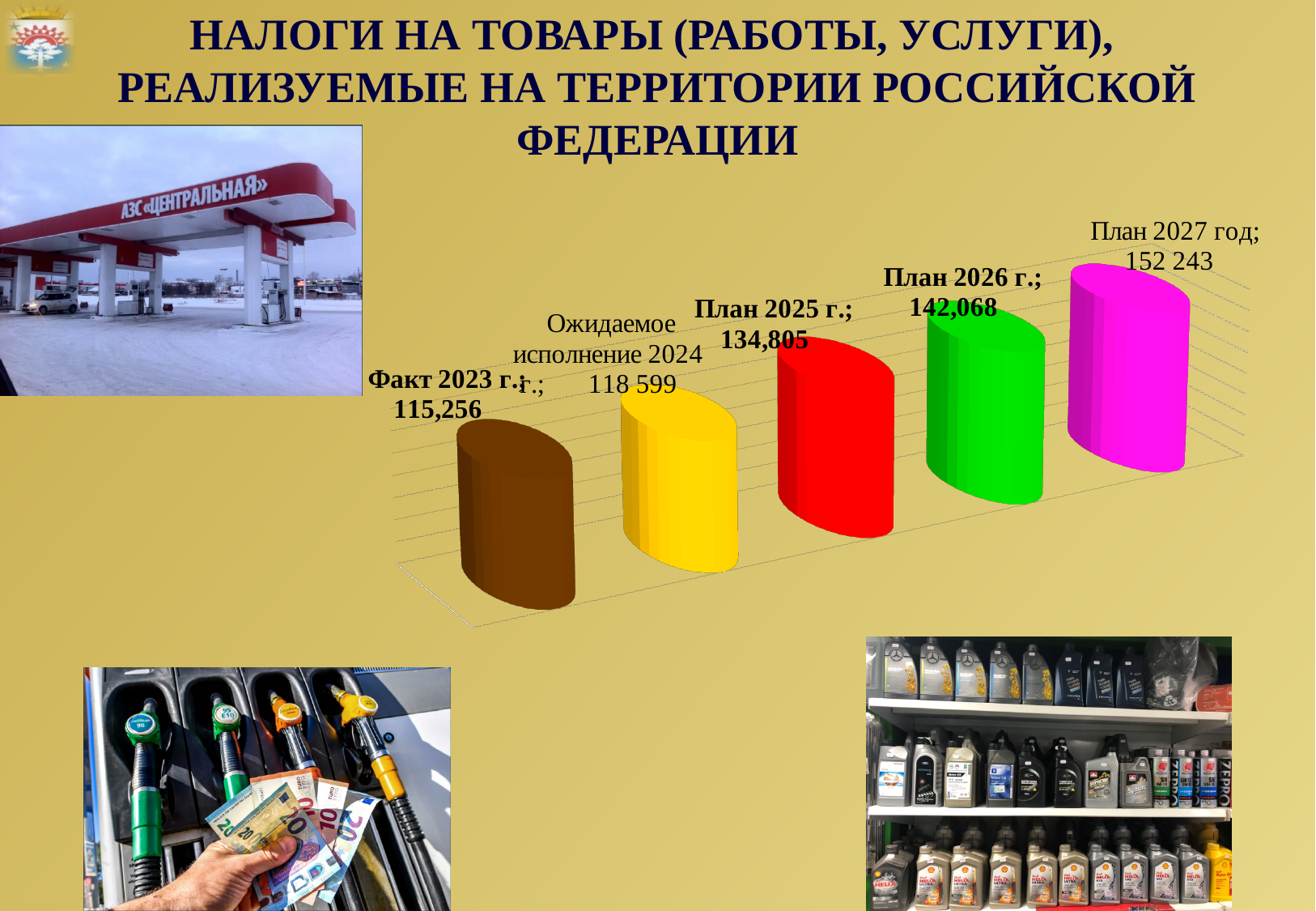
What is the value for План 2027 год? 152 243 What is the value for План 2026 г.? 142,068 Do the values rise or fall from Факт 2023 г. to План 2027 год? Rise What is the value for Ожидаемое исполнение 2024 г.? 118 599 How many categories are shown in the chart? 5 What is the value for План 2025 г.? 134,805 What kind of chart is shown on the slide? Bar chart What is the value for Факт 2023 г.? 115,256 Which category has the highest value? План 2027 год What is the difference between the values for План 2026 г. and План 2025 г.? 7,263 Which is larger, the value for План 2025 г. or the value for Ожидаемое исполнение 2024 г.? План 2025 г. Which category has the lowest value? Факт 2023 г.